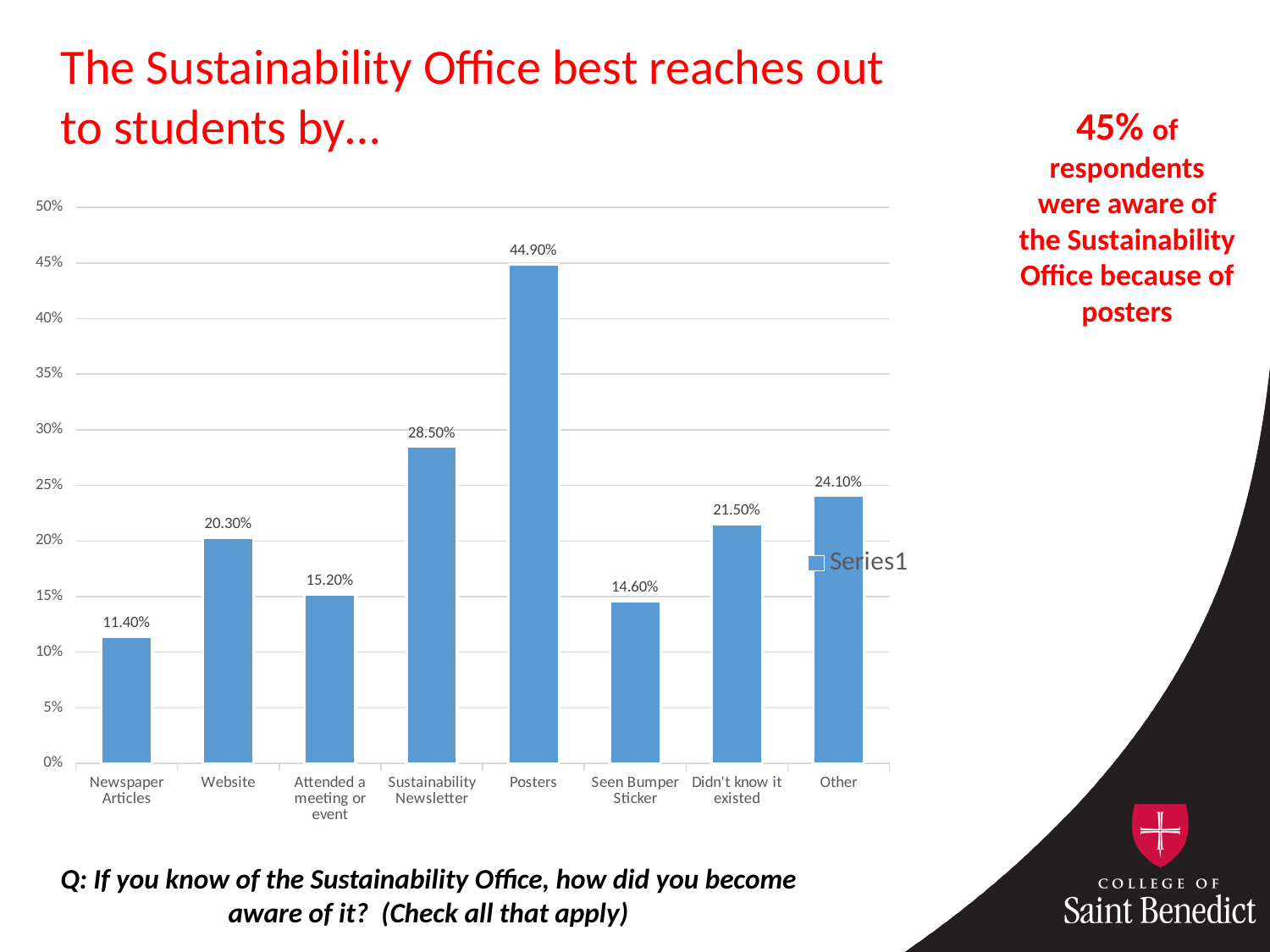
What is the difference between the values for Website and Attended a meeting or event? 5.10% What kind of chart is shown on the slide? Bar chart How many categories are shown on the x axis? 8 What is the value for Posters? 44.90% Is the value for Sustainability Newsletter greater or less than 25%? greater Which is larger, the value for Other or the value for Seen Bumper Sticker? Other What is the value for Newspaper Articles? 11.40% Which category has the highest value? Posters What is the difference between the values for Posters and Sustainability Newsletter? 16.40% How many series does the legend list? 1 Which category has the lowest value? Newspaper Articles What is the value for Didn't know it existed? 21.50%